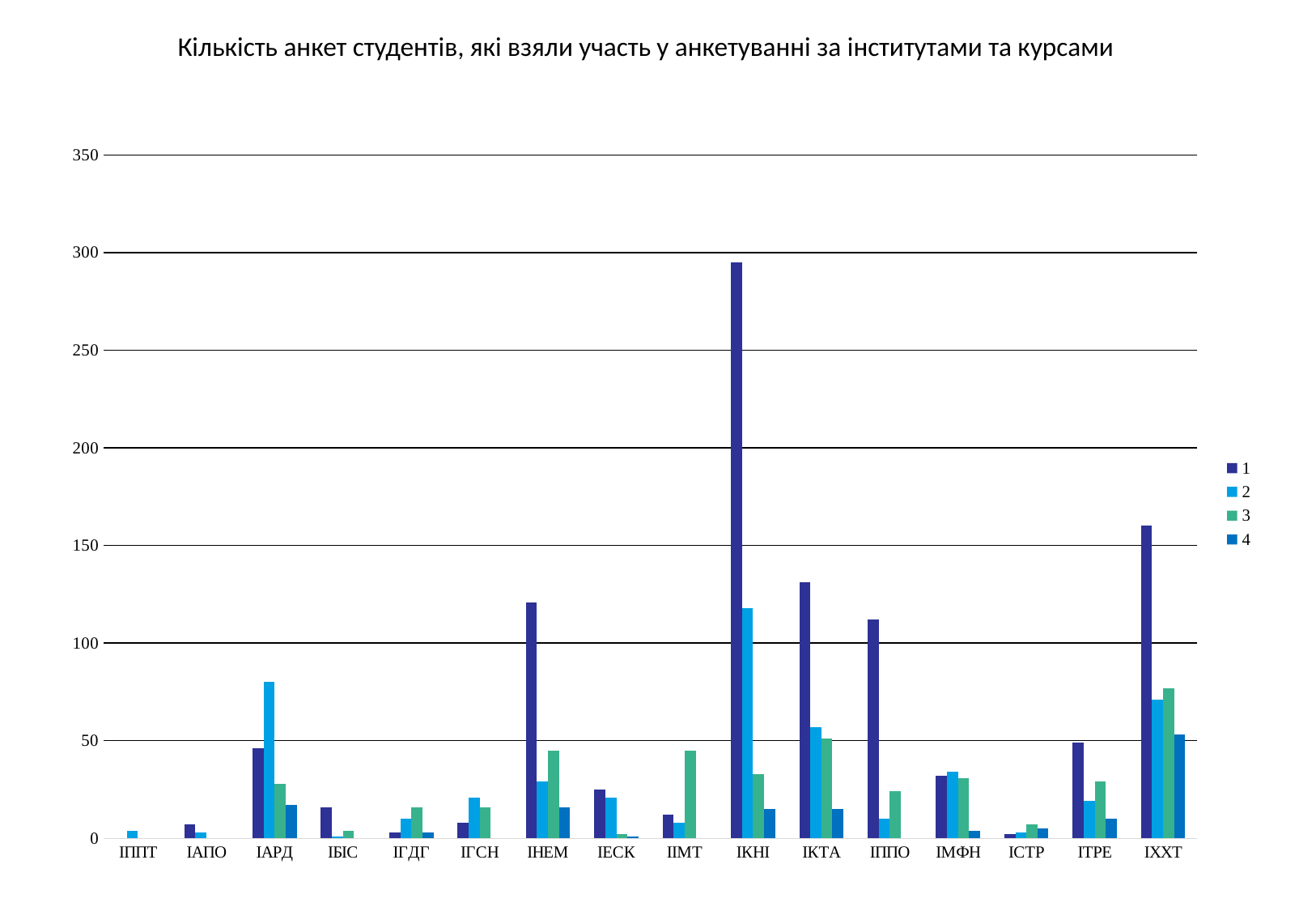
Is the value for ІНЕМ in series 1 greater or less than 100? greater Is the value for ІАРД in series 2 greater or less than 50? greater Is the value for ІХХТ in series 1 greater or less than 150? greater Which institute has the highest value for series 1? ІКНІ Which is larger for series 2: ІКНІ or ІКТА? ІКНІ What is the title of the chart? Кількість анкет студентів, які взяли участь у анкетуванні за інститутами та курсами Which institute has the highest value for series 3? ІХХТ How many institutes (categories) are shown along the x axis? 16 How many series does the legend list? 4 What kind of chart is shown on the slide? bar chart Which is larger for series 1: ІКТА or ІППО? ІКТА